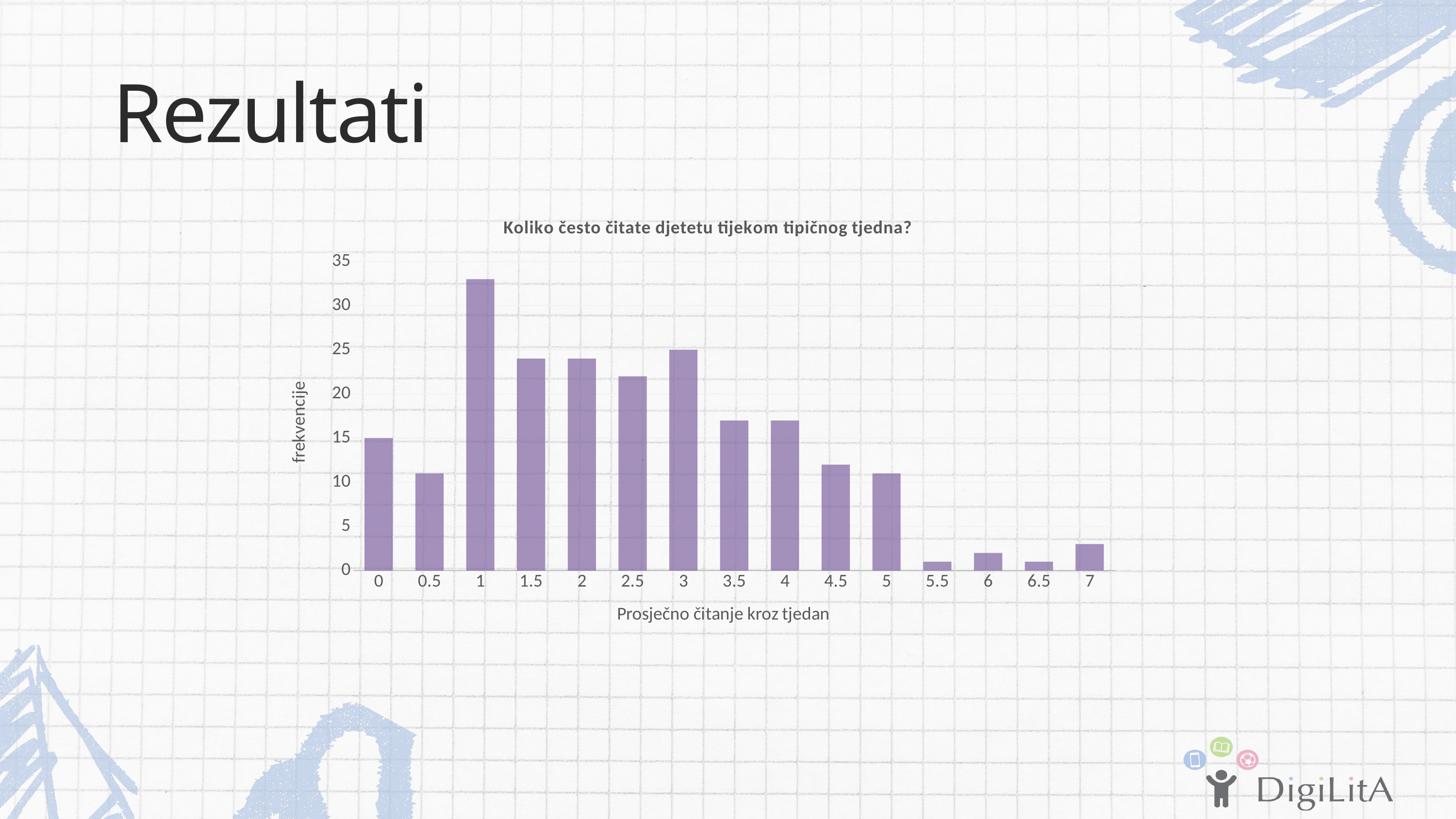
Which has a larger value, category 0 or category 6? 0 What is the title of the chart? Koliko često čitate djetetu tijekom tipičnog tjedna? Is the value for category 1 greater or less than 30? greater Which category has the highest frequency? 1 What is the label of the x axis? Prosječno čitanje kroz tjedan Is the value for category 7 greater or less than 5? less Is the value for category 0.5 greater or less than 15? less Which has a larger value, category 1 or category 3? 1 What type of chart is shown on the slide? bar chart How many categories are shown on the x axis? 15